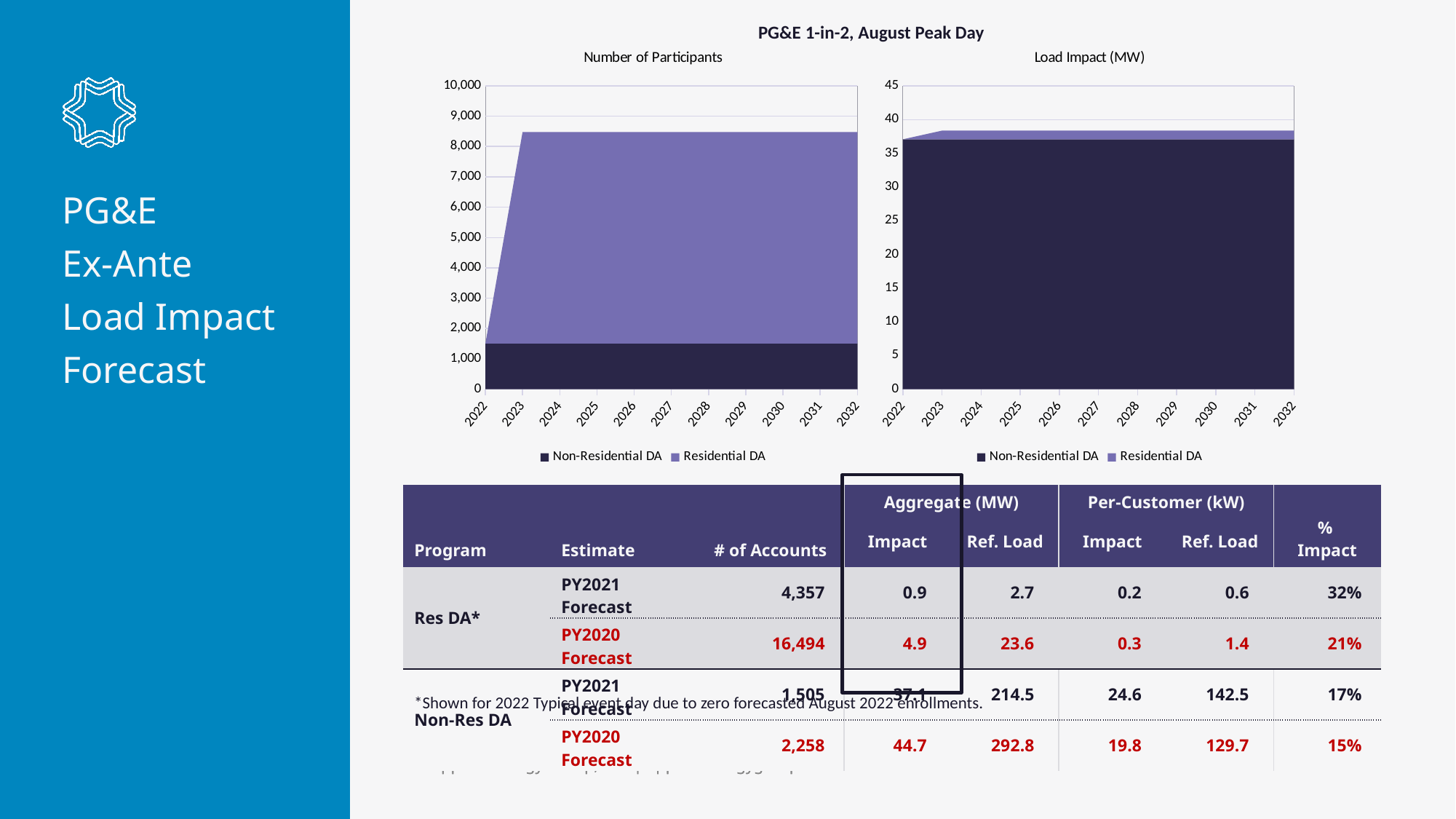
In the Number of Participants chart, does the total number of participants rise or fall between 2022 and 2023? rise In the Number of Participants chart, is the Non-Residential DA value in 2022 greater or less than 2,000? less How many series does the legend of the Load Impact (MW) chart list? 2 In the Number of Participants chart, is the total number of participants in 2032 greater or less than 8,000? greater In the Load Impact (MW) chart, is the Residential DA value in 2032 greater or less than 5? less In the Number of Participants chart, which year has the lowest total number of participants? 2022 What is the overall title above the two charts? PG&E 1-in-2, August Peak Day What are the two legend entries of the Number of Participants chart? Non-Residential DA and Residential DA How many years are shown on the x axis of the Number of Participants chart? 11 In the Load Impact (MW) chart, which series is larger in 2032, Non-Residential DA or Residential DA? Non-Residential DA What kind of chart is the Number of Participants chart? Stacked area chart